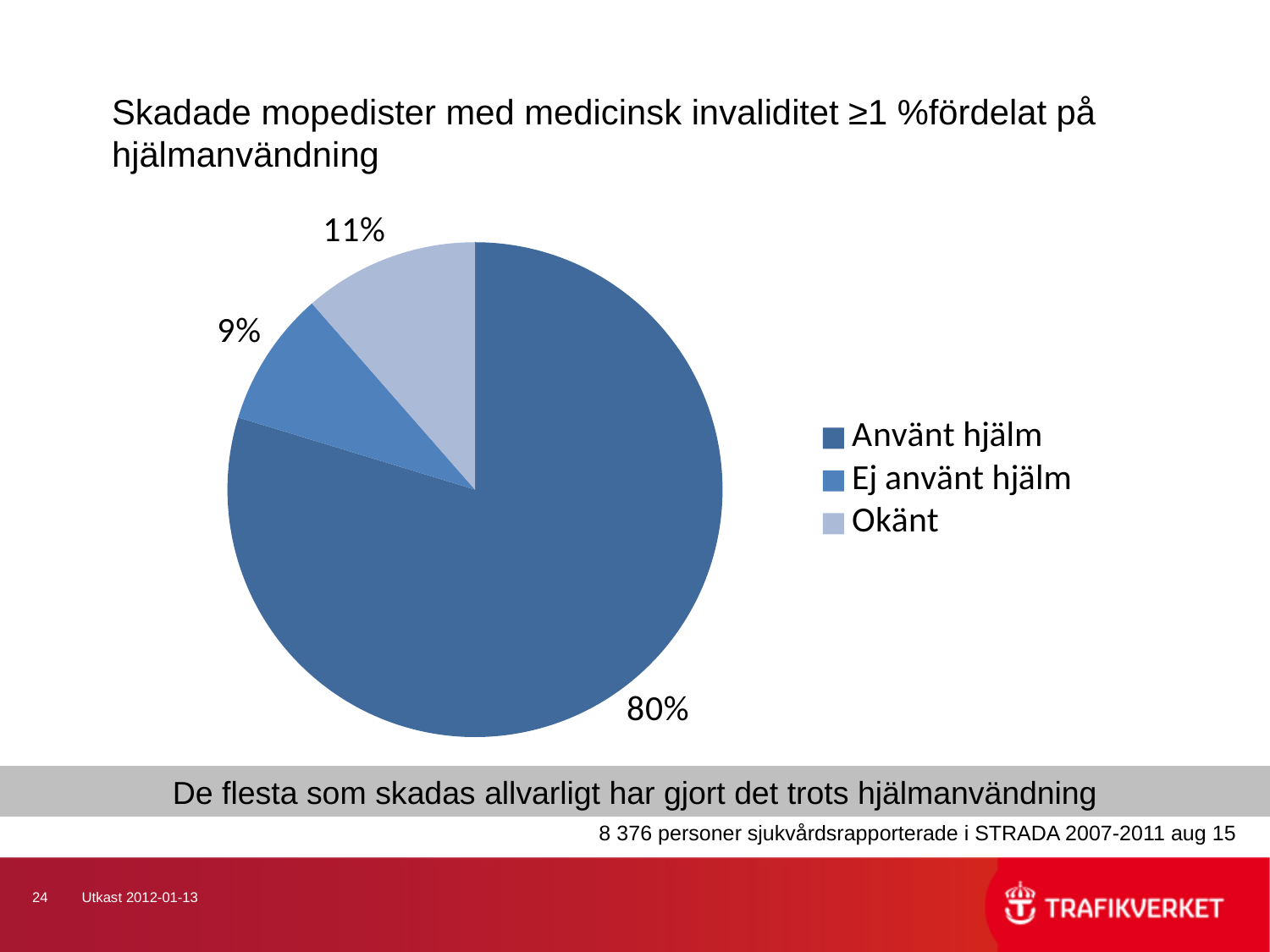
What share of the pie does "Använt hjälm" represent? 80% What is the difference in percentage points between "Använt hjälm" and "Okänt"? 69 Which is larger, the slice for "Okänt" or the slice for "Ej använt hjälm"? Okänt What share of the pie does "Ej använt hjälm" represent? 9% What is the title of the chart? Skadade mopedister med medicinsk invaliditet ≥1 %fördelat på hjälmanvändning How many slices does the pie chart have? 3 How many entries does the legend list? 3 What kind of chart is shown on the slide? pie chart What is the difference in percentage points between "Okänt" and "Ej använt hjälm"? 2 What share of the pie does "Okänt" represent? 11% Which category has the smallest slice of the pie? Ej använt hjälm Which category has the largest slice of the pie? Använt hjälm